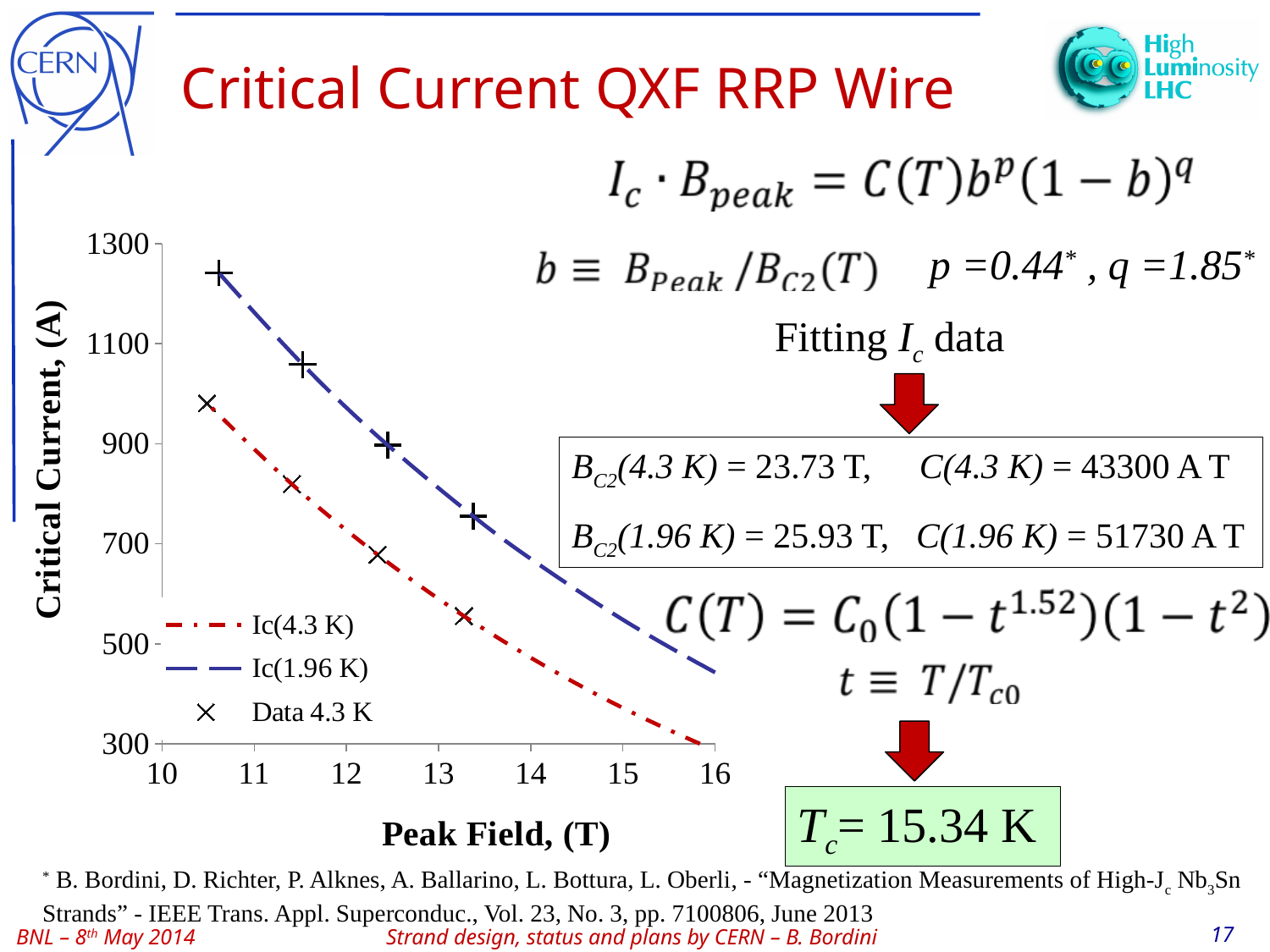
How many series does the chart legend list? 3 At a peak field of 12 T, which curve is higher, Ic(4.3 K) or Ic(1.96 K)? Ic(1.96 K) What is the title of the x axis of the chart? Peak Field, (T) Is the value of the Ic(4.3 K) curve at 14 T greater or less than 700? less What are the three entries in the chart legend? Ic(4.3 K), Ic(1.96 K), Data 4.3 K What is the highest value shown on the y axis of the chart? 1300 What kind of chart is shown on the slide? line chart Is the value of the Ic(1.96 K) curve at 11 T greater or less than 1100? less Is the value of the Ic(1.96 K) curve at 14 T greater or less than 900? less Do the critical current curves rise or fall as peak field increases along the x axis? fall